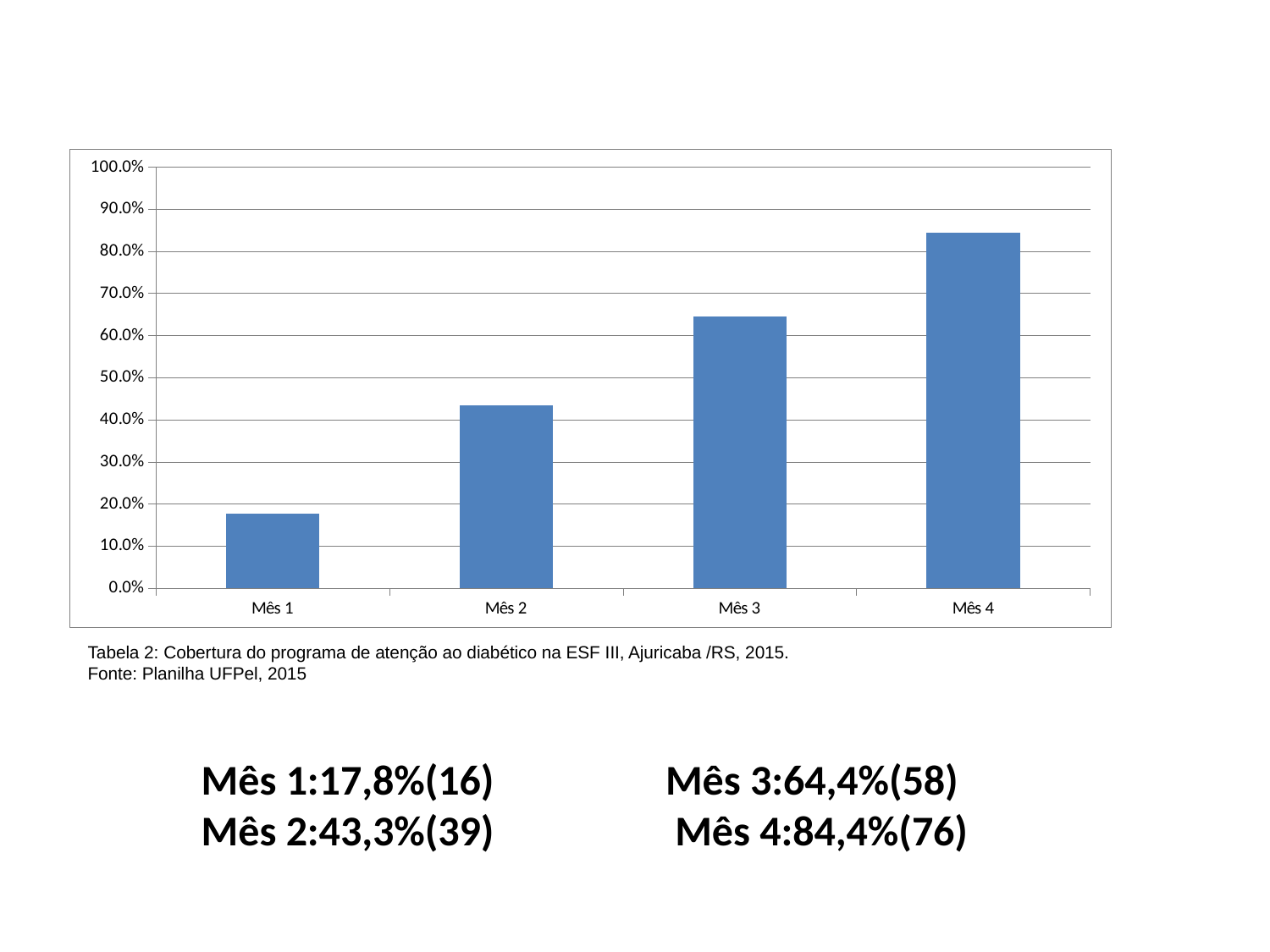
Is the value for Mês 4 greater or less than 80.0%? greater Which month has the highest value? Mês 4 What is the value for Mês 3? 64,4% How many months are shown on the x axis? 4 What is the difference between the values for Mês 4 and Mês 1? 66,6% Which month has the lowest value? Mês 1 What is the value for Mês 1? 17,8% Is the value for Mês 2 greater or less than 50.0%? less What kind of chart is shown? bar chart Which is larger, the value for Mês 2 or the value for Mês 3? Mês 3 What is the difference between the values for Mês 2 and Mês 1? 25,5% Do the values rise or fall from Mês 1 to Mês 4? rise